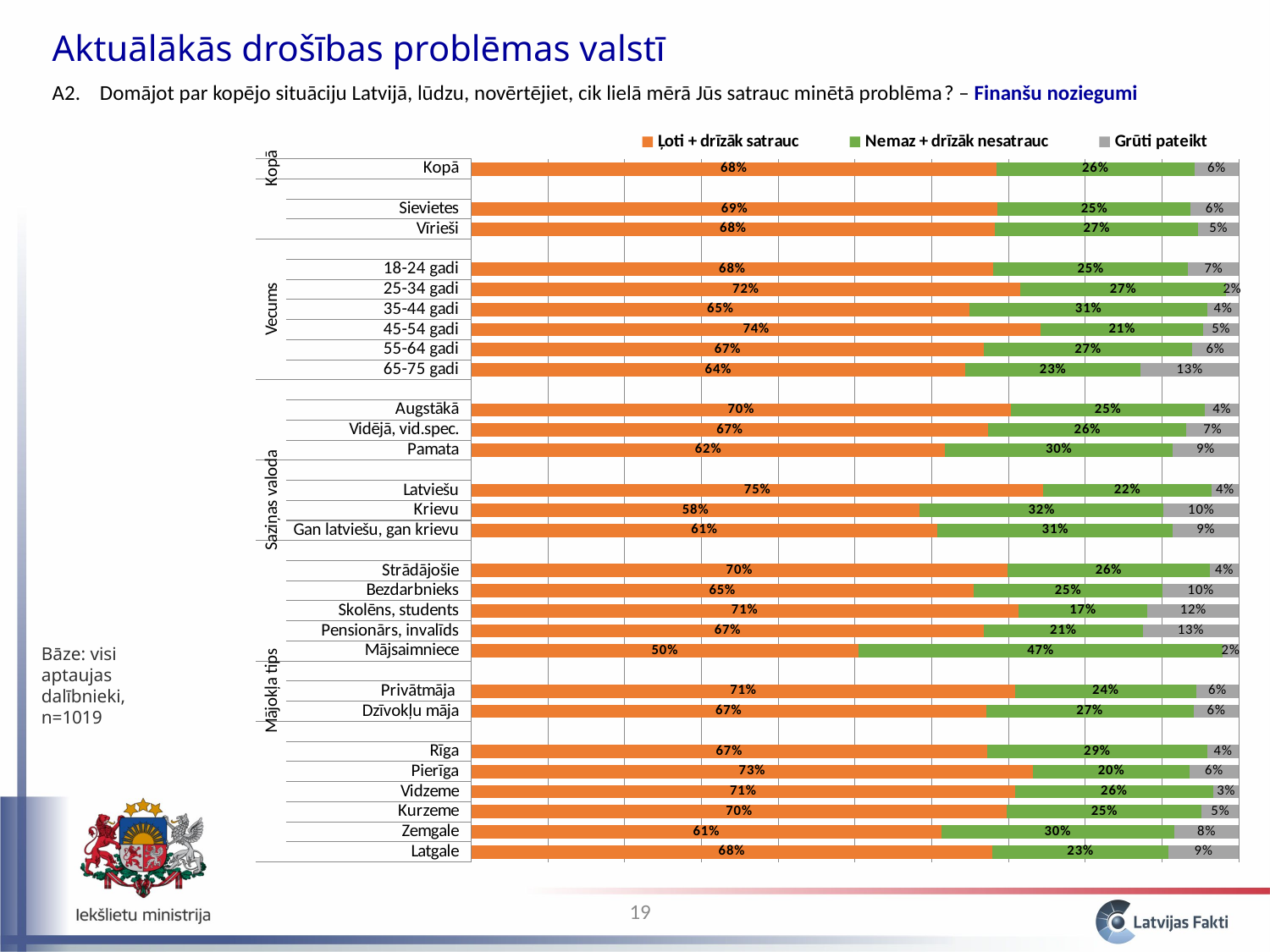
What is the value of "Grūti pateikt" for Skolēns, students? 12% How many series does the legend list? 3 What is the value of "Nemaz + drīzāk nesatrauc" for Mājsaimniece? 47% Which has a larger "Ļoti + drīzāk satrauc" value, Pierīga or Zemgale? Pierīga Which category has the highest value for "Nemaz + drīzāk nesatrauc"? Mājsaimniece Which category has the highest value for "Ļoti + drīzāk satrauc"? Latviešu What is the value of "Grūti pateikt" for 65-75 gadi? 13% What kind of chart is shown on the slide? bar chart What is the difference between the "Ļoti + drīzāk satrauc" values for Latviešu and Krievu? 17% What is the value of "Nemaz + drīzāk nesatrauc" for Rīga? 29% Which category has the lowest value for "Ļoti + drīzāk satrauc"? Mājsaimniece What is the value of "Ļoti + drīzāk satrauc" for Kopā? 68%